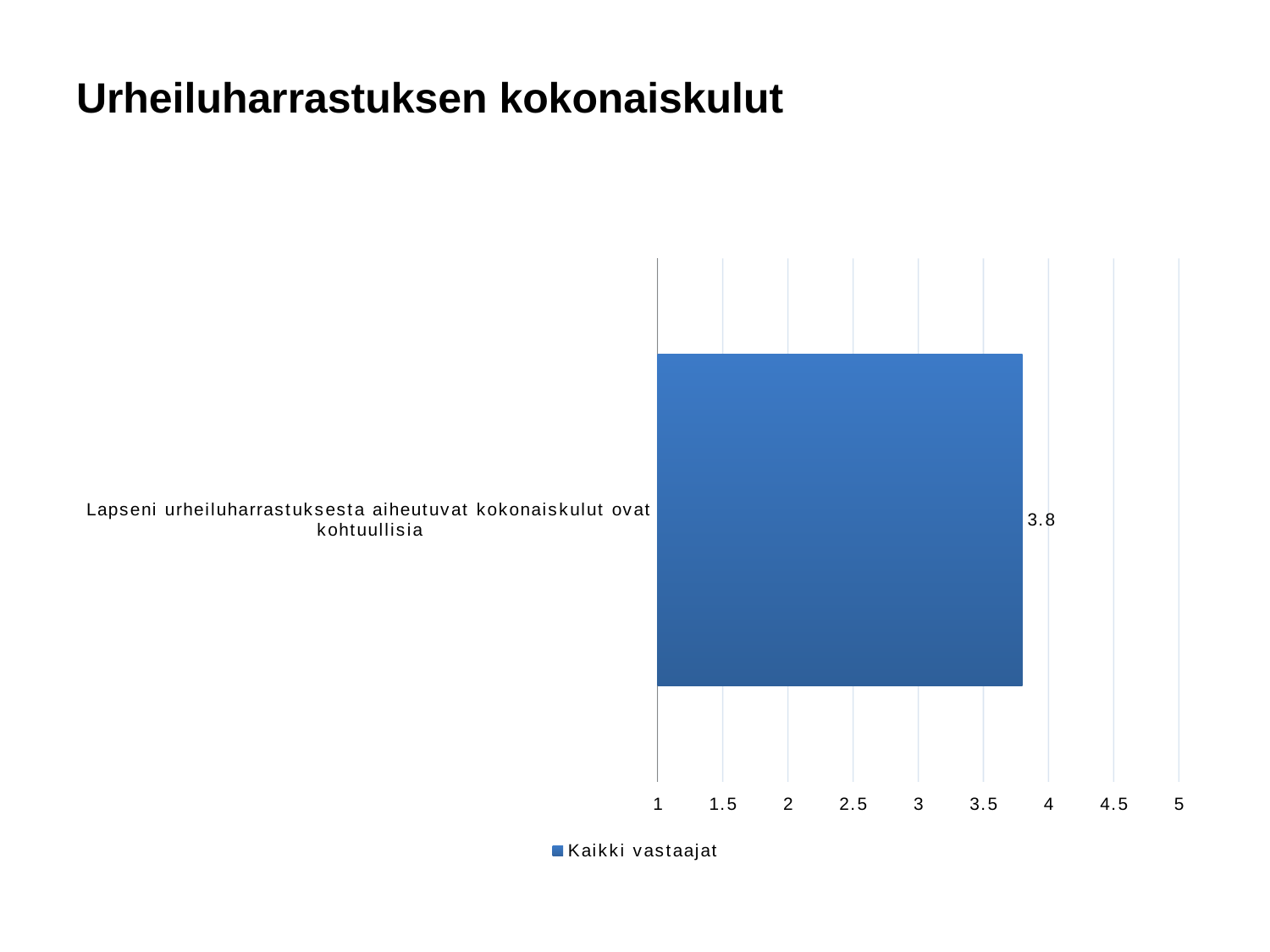
What series name is shown in the legend? Kaikki vastaajat Is the value for "Lapseni urheiluharrastuksesta aiheutuvat kokonaiskulut ovat kohtuullisia" greater or less than 4? less What is the lowest value shown on the x axis? 1 What is the highest value shown on the x axis? 5 What is the title of the slide? Urheiluharrastuksen kokonaiskulut How many categories are plotted in the chart? 1 How many series does the legend list? 1 What is the value for the series "Kaikki vastaajat"? 3.8 What is the value for "Lapseni urheiluharrastuksesta aiheutuvat kokonaiskulut ovat kohtuullisia"? 3.8 What kind of chart is shown on the slide? bar chart Is the value for "Lapseni urheiluharrastuksesta aiheutuvat kokonaiskulut ovat kohtuullisia" greater or less than 3? greater